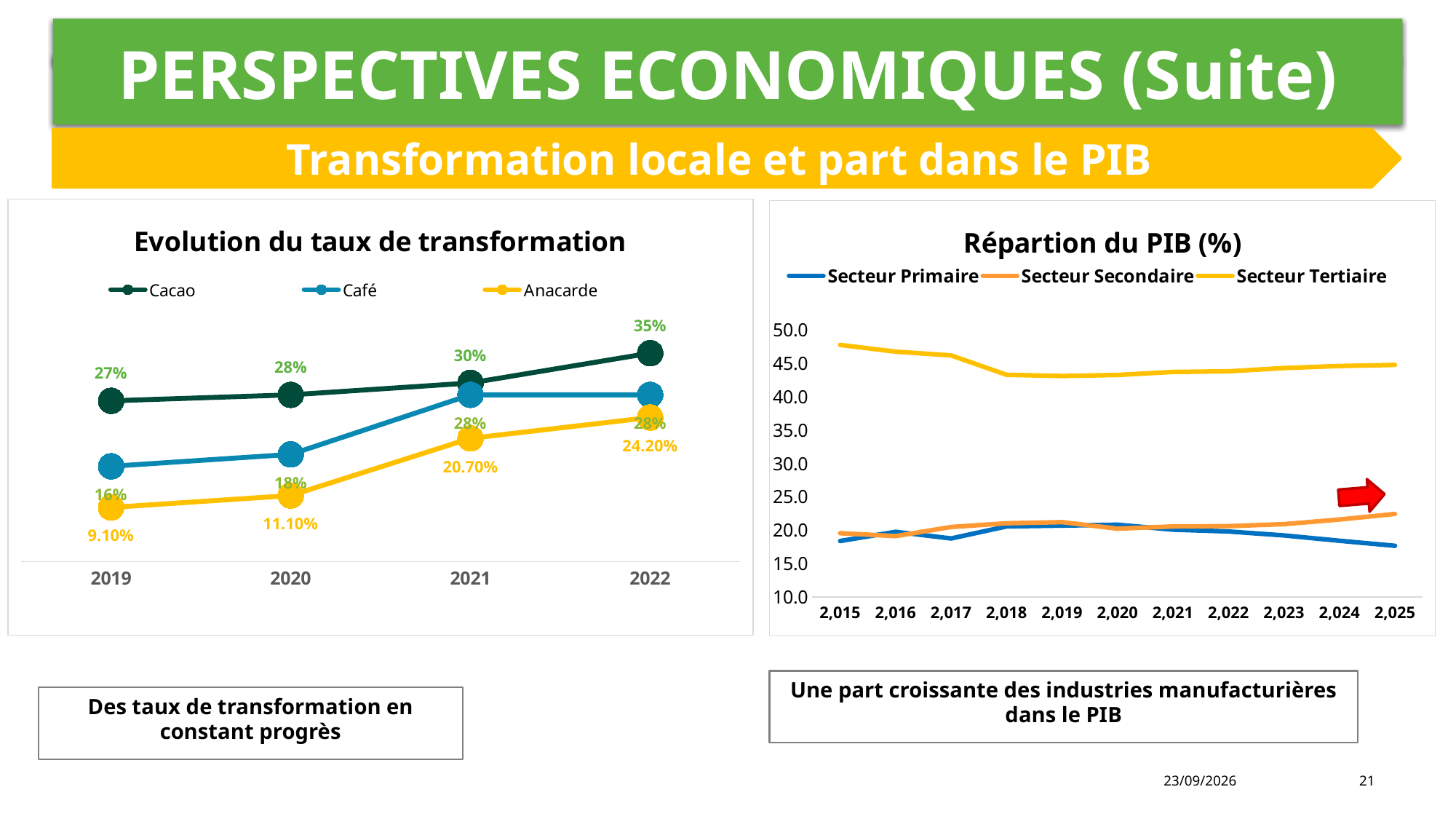
In the chart 'Evolution du taux de transformation', by how many percentage points did Cacao increase from 2019 to 2022? 8 percentage points In the chart 'Evolution du taux de transformation', what is the value for Anacarde in 2019? 9.10% In the chart 'Evolution du taux de transformation', what is the value for Cacao in 2022? 35% In the chart 'Evolution du taux de transformation', which series has the highest value in 2019? Cacao In the chart 'Répartion du PIB (%)', is the value for Secteur Tertiaire in 2,015 greater or less than 45.0? greater In the chart 'Evolution du taux de transformation', what is the value for Café in 2021? 28% In the chart 'Evolution du taux de transformation', how many series does the legend list? 3 What kind of chart is 'Répartion du PIB (%)'? line chart In the chart 'Evolution du taux de transformation', does the Anacarde series rise or fall from 2019 to 2022? rise In the chart 'Répartion du PIB (%)', how many years are shown on the x axis? 11 In the chart 'Evolution du taux de transformation', which is larger in 2020: Café or Anacarde? Café In the chart 'Répartion du PIB (%)', which sector has the highest value in 2,025? Secteur Tertiaire